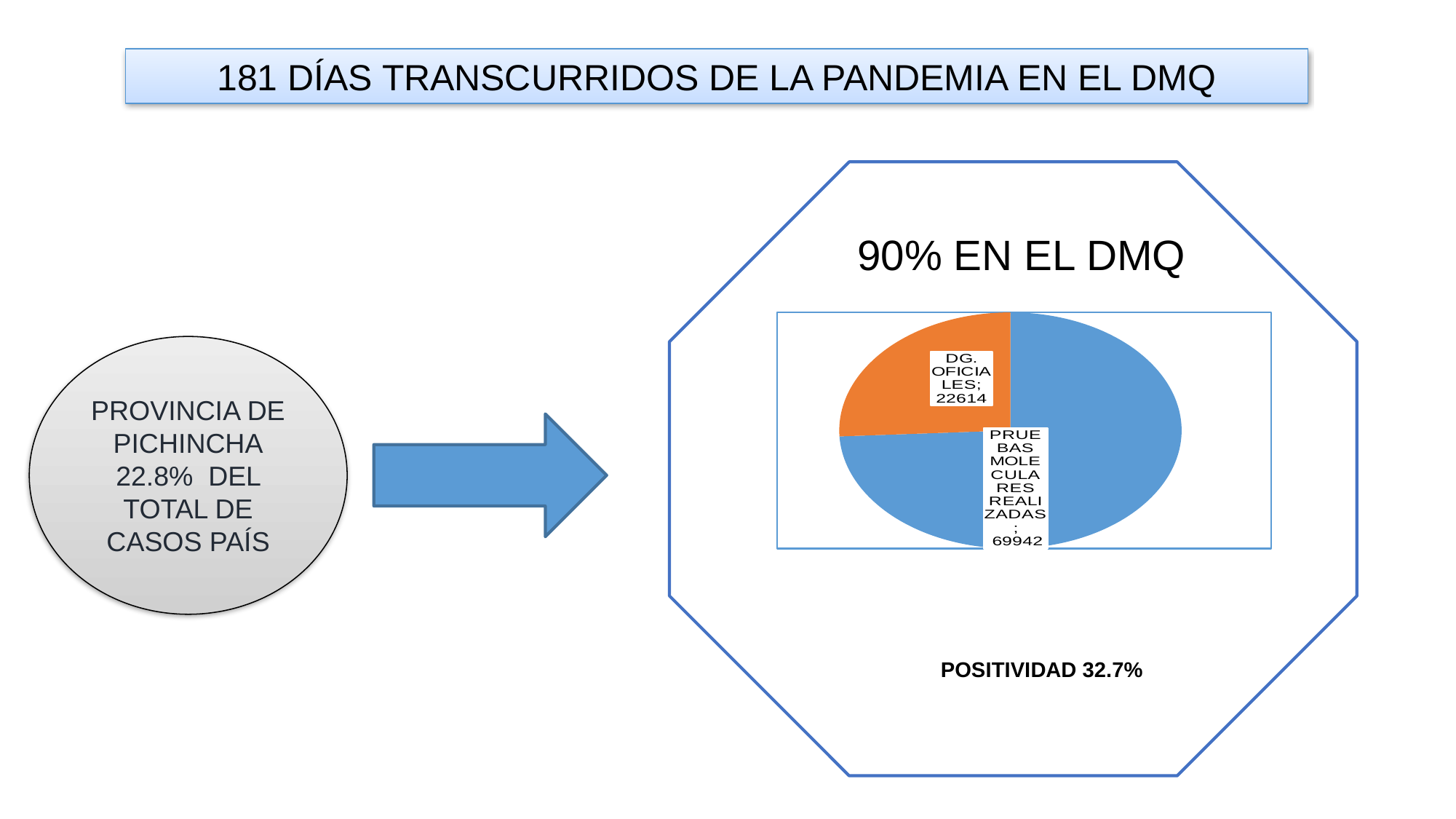
What is the total of the two values shown in the pie chart? 92556 What colour is the PRUEBAS MOLECULARES REALIZADAS slice in the pie chart? blue Which slice of the pie chart has the largest value? PRUEBAS MOLECULARES REALIZADAS Which is larger in the pie chart, DG. OFICIALES or PRUEBAS MOLECULARES REALIZADAS? PRUEBAS MOLECULARES REALIZADAS What value is shown for DG. OFICIALES in the pie chart? 22614 How many slices does the pie chart have? 2 Which slice of the pie chart has the smallest value? DG. OFICIALES What kind of chart is shown on the slide? pie chart What value is shown for PRUEBAS MOLECULARES REALIZADAS in the pie chart? 69942 What is the difference between the PRUEBAS MOLECULARES REALIZADAS value and the DG. OFICIALES value in the pie chart? 47328 What colour is the DG. OFICIALES slice in the pie chart? orange